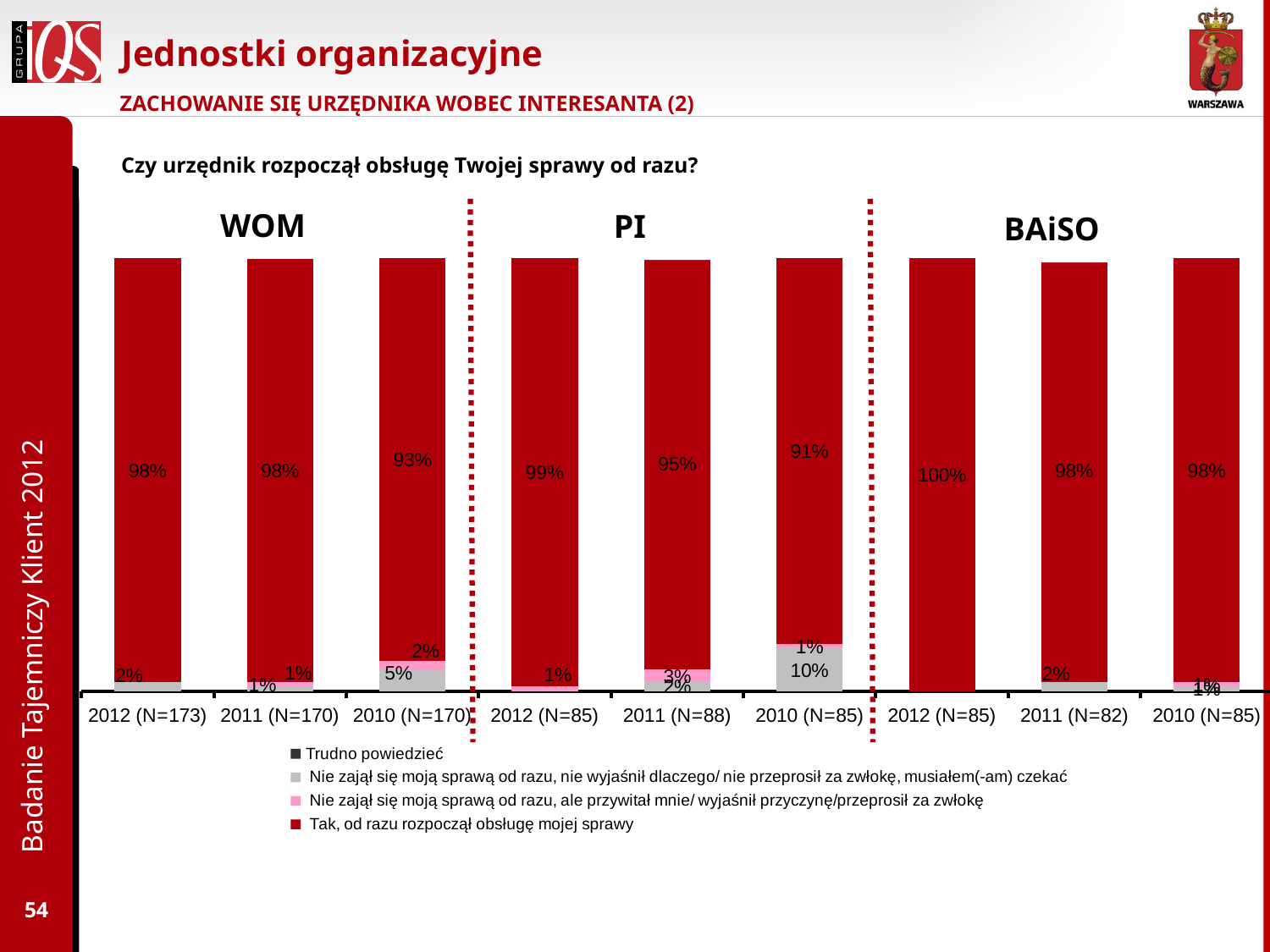
What is the difference between the 'Tak, od razu rozpoczął obsługę mojej sprawy' values for PI in 2012 (N=85) and PI in 2010 (N=85)? 8% What is the value of 'Tak, od razu rozpoczął obsługę mojej sprawy' for BAiSO in 2012 (N=85)? 100% How many bars are plotted in the chart? 9 Which bar has the highest value for 'Tak, od razu rozpoczął obsługę mojej sprawy'? BAiSO 2012 (N=85) What is the value of 'Nie zajął się moją sprawą od razu, nie wyjaśnił dlaczego/ nie przeprosił za zwłokę, musiałem(-am) czekać' for PI in 2010 (N=85)? 10% Which bar has the lowest value for 'Tak, od razu rozpoczął obsługę mojej sprawy'? PI 2010 (N=85) What is the value of 'Tak, od razu rozpoczął obsługę mojej sprawy' for WOM in 2010 (N=170)? 93% Does the 'Tak, od razu rozpoczął obsługę mojej sprawy' value for PI rise or fall from 2010 to 2012? rise What kind of chart is shown on the slide? bar chart Which is larger, the 'Tak, od razu rozpoczął obsługę mojej sprawy' value for WOM 2010 (N=170) or for PI 2011 (N=88)? PI 2011 (N=88) How many series does the legend list? 4 What is the value of 'Tak, od razu rozpoczął obsługę mojej sprawy' for PI in 2012 (N=85)? 99%